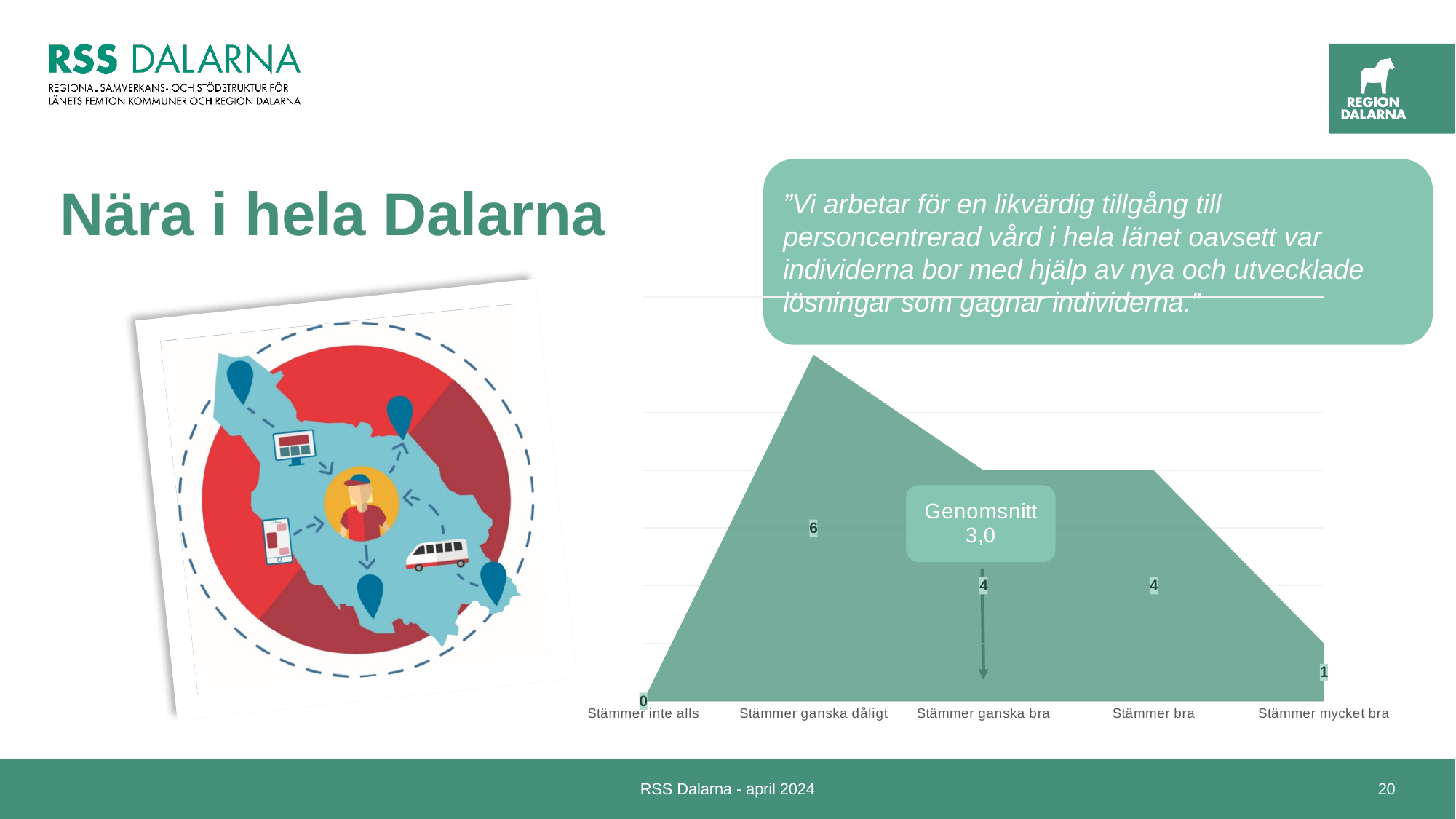
What is the value for "Stämmer ganska dåligt"? 6 What is the difference between the values for "Stämmer ganska dåligt" and "Stämmer ganska bra"? 2 What is the value for "Stämmer bra"? 4 What average (Genomsnitt) is shown in the label on the chart? 3,0 Do the values rise or fall from "Stämmer ganska bra" to "Stämmer mycket bra"? Fall What is the value for "Stämmer mycket bra"? 1 How many categories are shown on the x axis of the chart? 5 What is the value for "Stämmer inte alls"? 0 Which category has the lowest value? Stämmer inte alls What kind of chart is shown on the slide? Area chart Which category has the highest value? Stämmer ganska dåligt Which is larger, the value for "Stämmer bra" or the value for "Stämmer mycket bra"? Stämmer bra